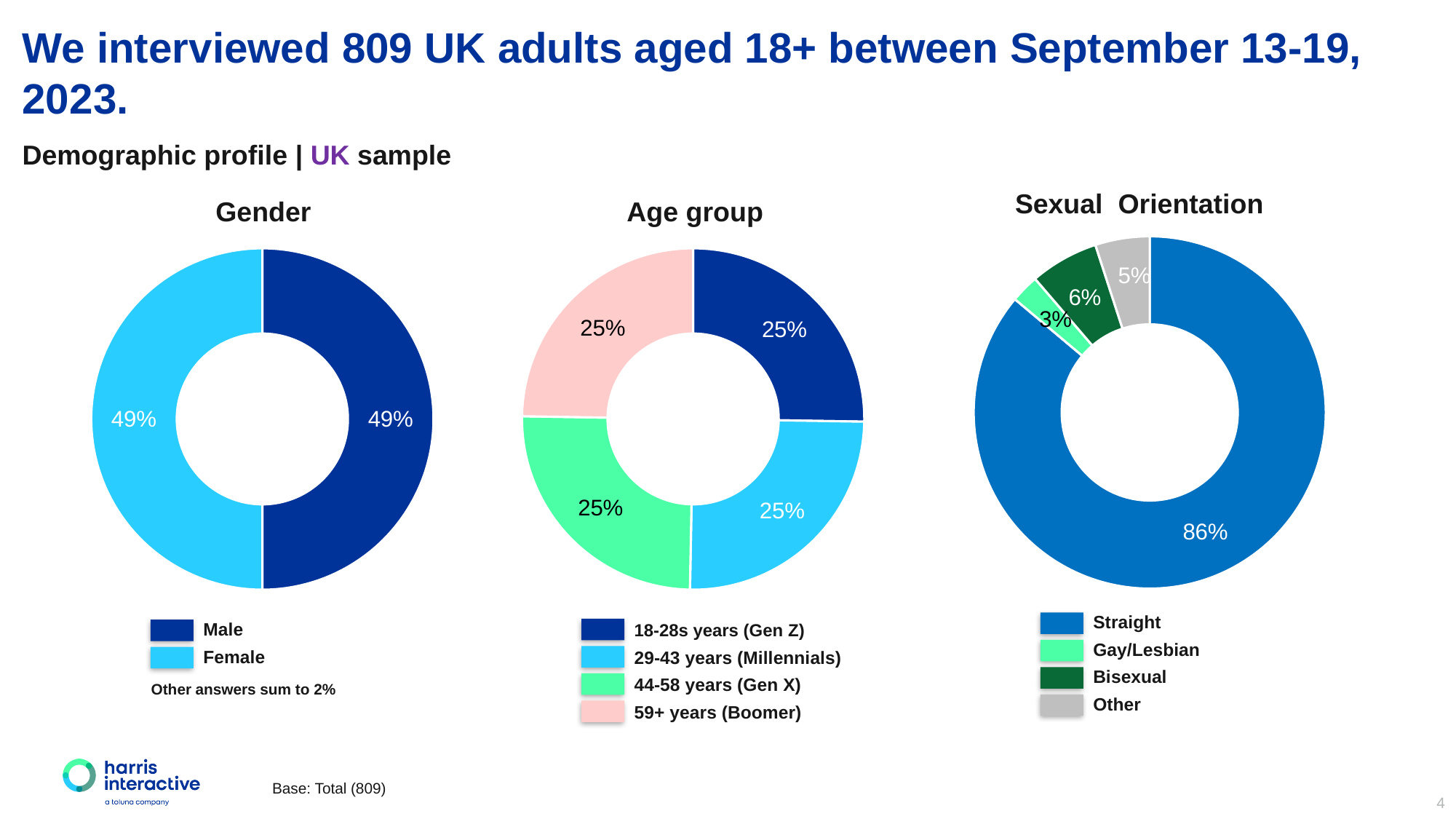
In the Age group chart, which legend entry is shown in pink? 59+ years (Boomer) In the Gender chart, what percentage of the sample is Female? 49% In the Age group chart, what percentage of the sample is 44-58 years (Gen X)? 25% In the Sexual Orientation chart, what is the difference between the Straight share and the Other share? 81% In the Sexual Orientation chart, which is larger, the Bisexual share or the Gay/Lesbian share? Bisexual What type of chart is the Gender chart? Donut chart In the Sexual Orientation chart, which category has the largest share? Straight In the Sexual Orientation chart, what percentage of the sample is Straight? 86% In the Sexual Orientation chart, what percentage of the sample is Bisexual? 6% In the Age group chart, how many age categories are shown? 4 In the Sexual Orientation chart, which category has the smallest share? Gay/Lesbian In the Gender chart, what percentage of the sample is Male? 49%